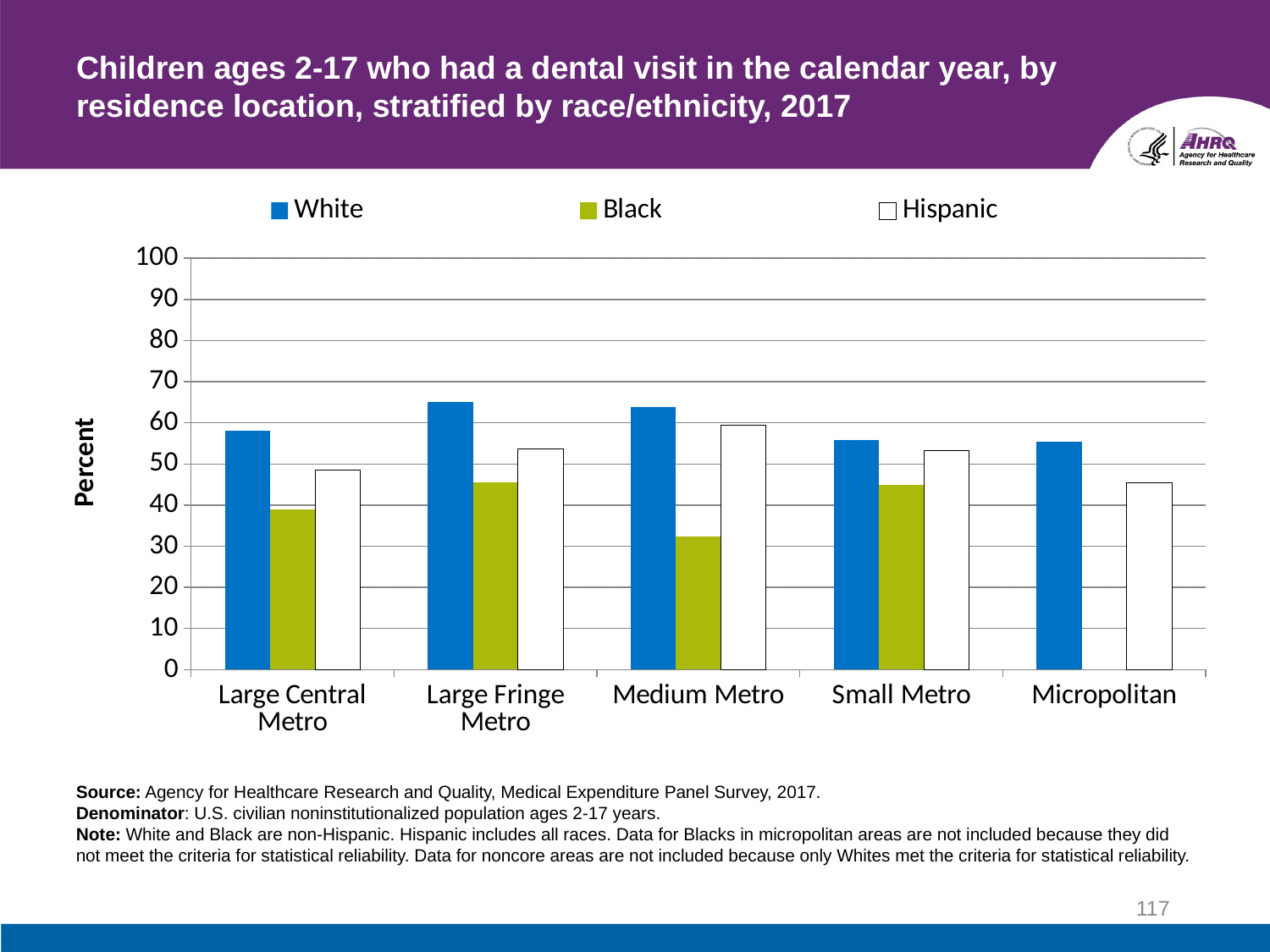
What is the label on the vertical axis? Percent Is the value for Black children in Medium Metro greater or less than 40? less Is the value for White children in Micropolitan areas greater or less than 50? greater Which residence location has the highest value for Hispanic children? Medium Metro What kind of chart is shown on the slide? Bar chart In Large Central Metro, which is larger: the value for White children or for Hispanic children? White Is the value for Hispanic children in Medium Metro greater or less than 50? greater In Medium Metro, which is larger: the value for Black children or for Hispanic children? Hispanic Which residence location has the lowest value for Black children? Medium Metro How many series does the legend list? 3 How many residence location categories are shown on the x axis? 5